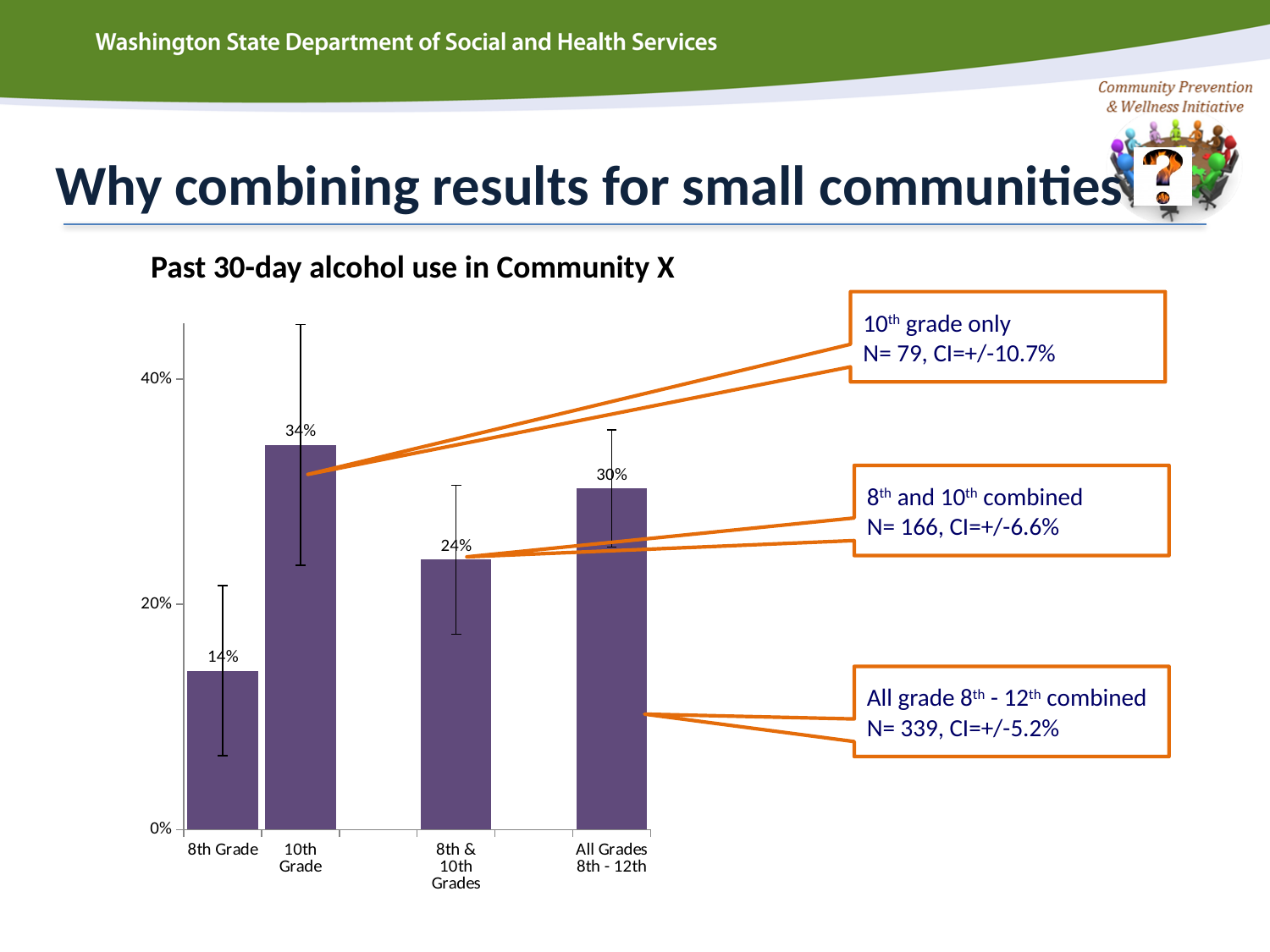
What kind of chart is shown on the slide? bar chart What is the title of the chart? Past 30-day alcohol use in Community X Which category has the highest past 30-day alcohol use? 10th Grade What is the difference between the 10th Grade value and the 8th Grade value? 20% What is the past 30-day alcohol use value for 10th Grade? 34% What is the past 30-day alcohol use value for 8th Grade? 14% What is the value for All Grades 8th - 12th? 30% Which category has the lowest past 30-day alcohol use? 8th Grade What is the value for 8th & 10th Grades combined? 24% Is the value for 8th Grade greater or less than 20%? less Which is larger, the value for All Grades 8th - 12th or the value for 8th & 10th Grades? All Grades 8th - 12th How many categories are shown on the x axis of the chart? 4